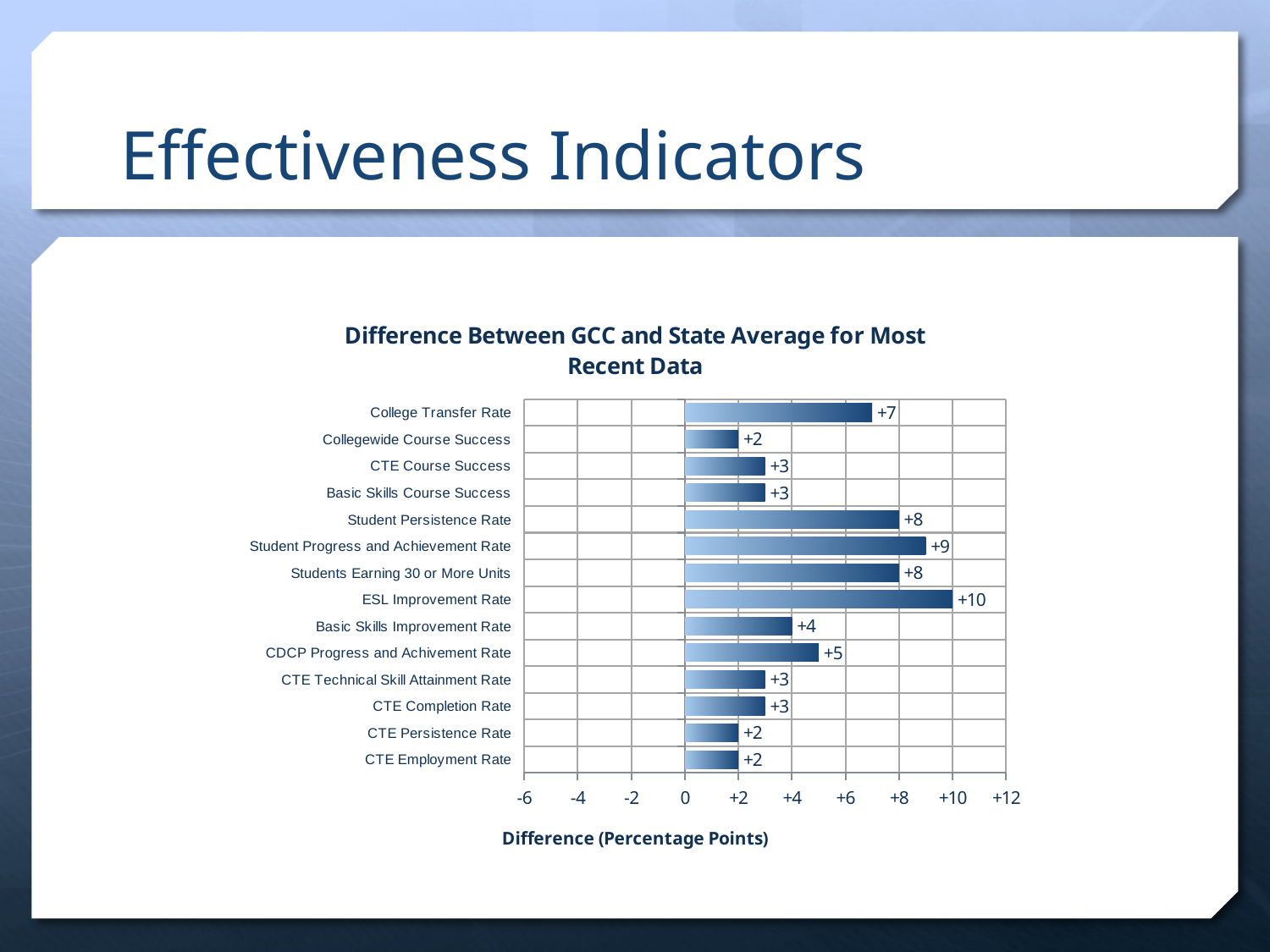
Which category has the highest value? ESL Improvement Rate What is the difference between the values for Student Progress and Achievement Rate and Collegewide Course Success? 7 What is the label of the horizontal axis? Difference (Percentage Points) What is the value for ESL Improvement Rate? +10 What is the title of the chart? Difference Between GCC and State Average for Most Recent Data What is the value for College Transfer Rate? +7 What is the value for CTE Employment Rate? +2 What kind of chart is shown on the slide? bar chart How many categories are shown on the chart? 14 Is the value for Students Earning 30 or More Units greater or less than +6? greater What is the value for CDCP Progress and Achivement Rate? +5 Which is larger, the value for Student Persistence Rate or the value for Basic Skills Improvement Rate? Student Persistence Rate